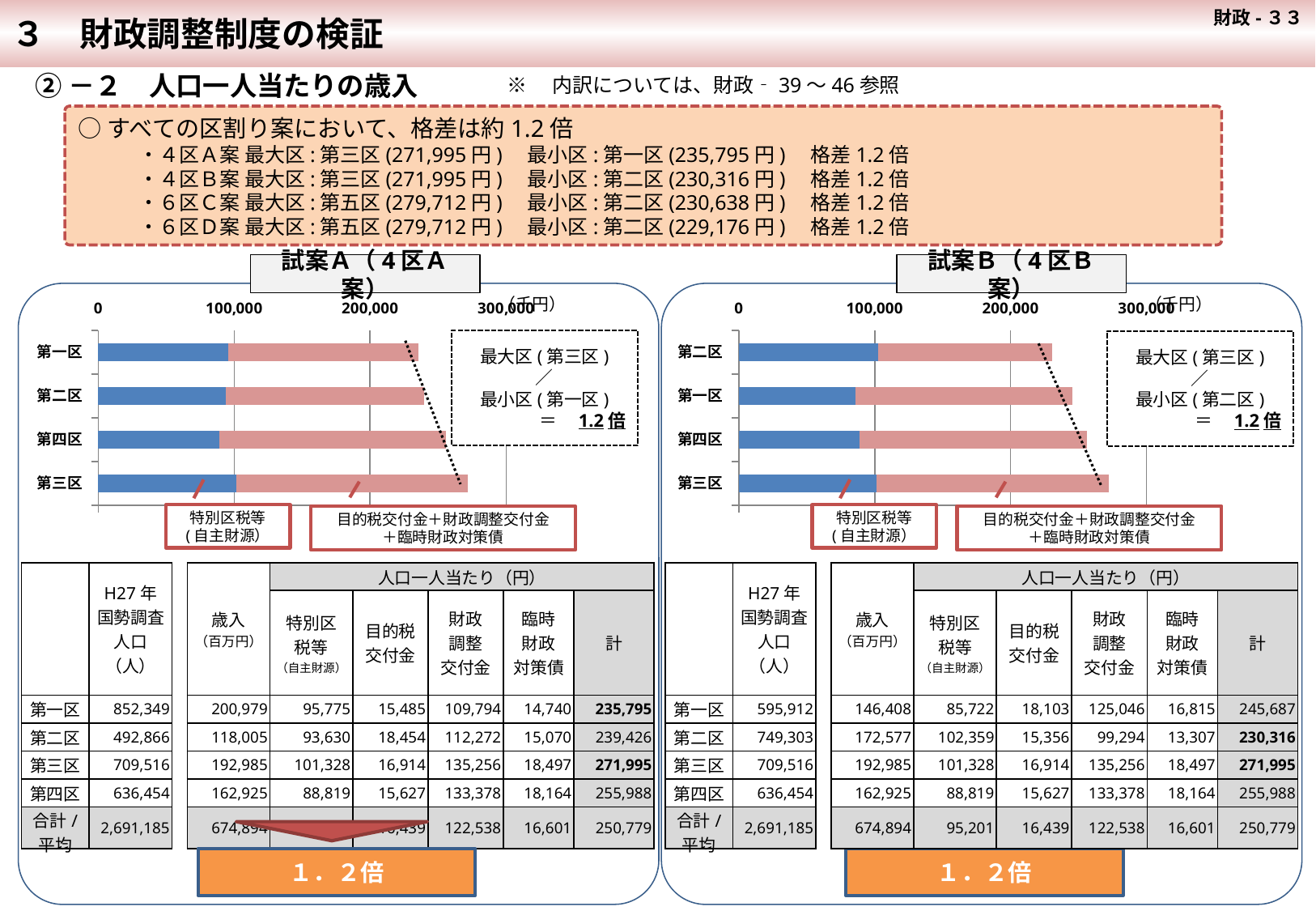
In the 試案B（4区B案） chart, how many series make up each stacked bar? 2 In the 試案A（4区A案） chart, which ward has the longest bar? 第三区 In the 試案A（4区A案） chart, how many wards (categories) are plotted? 4 In the 試案A（4区A案） chart, what is the difference in 円 between the total for 第三区 (271,995) and the total for 第一区 (235,795)? 36,200 In the 試案B（4区B案） chart, which ward has the longest bar? 第三区 What kind of chart is shown under 試案A（4区A案）? bar chart In the 試案A（4区A案） chart, what is the total per-capita revenue (計) for 第三区 in 円? 271,995 In the 試案B（4区B案） chart, is the 特別区税等(自主財源) segment for 第一区 greater or less than 100,000? less In the 試案B（4区B案） chart, which bar is longer, 第一区 or 第二区? 第一区 In the 試案B（4区B案） chart, what is the total per-capita revenue (計) for 第二区 in 円? 230,316 In the 試案A（4区A案） chart, is the total bar for 第三区 greater or less than 200,000? greater In the 試案B（4区B案） chart, which ward has the shortest bar? 第二区